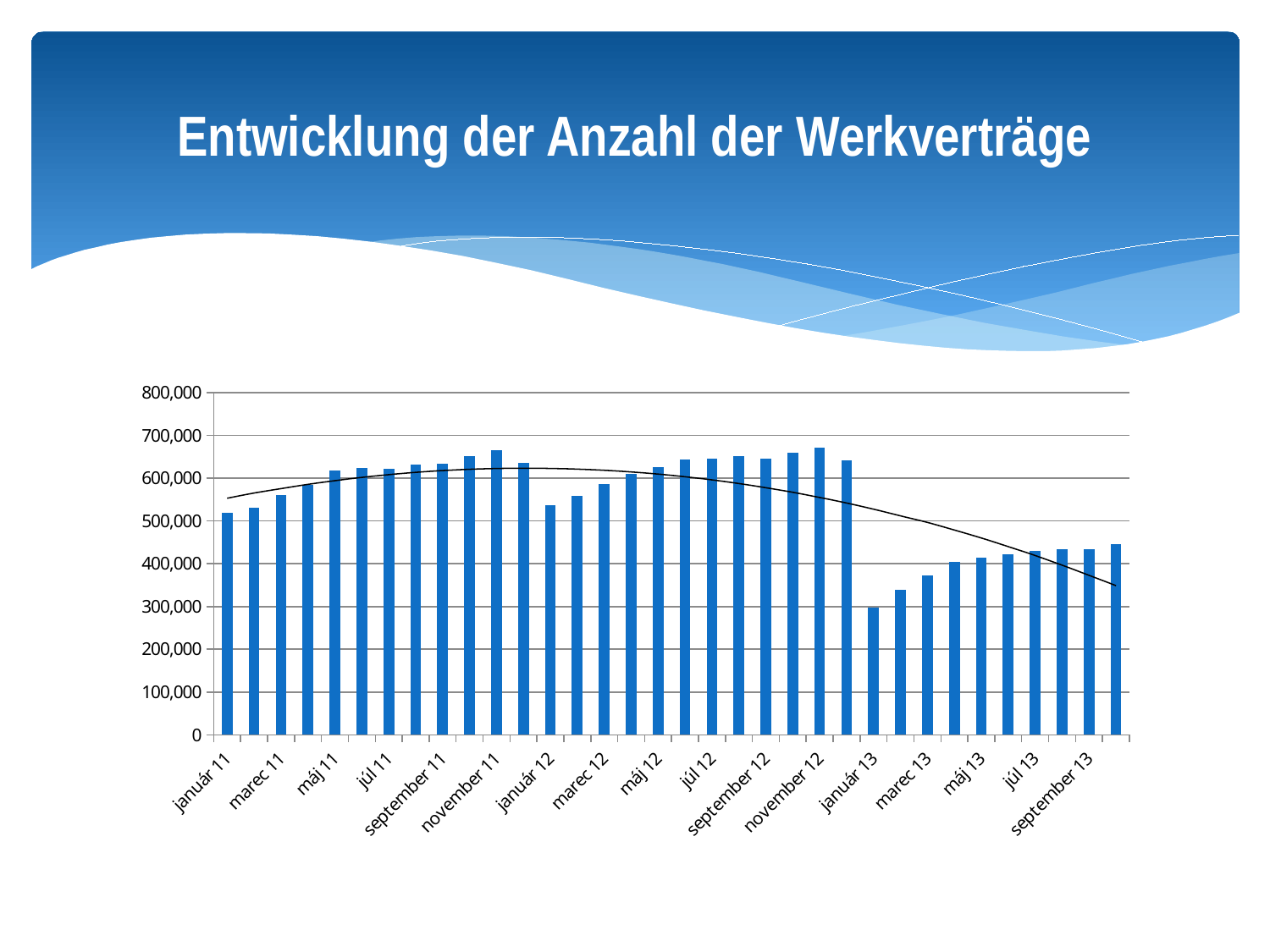
Which labelled month has the lowest value? január 13 Is the value for november 11 greater or less than 600,000? greater Which is larger, the value for november 12 or the value for január 13? november 12 Which is larger, the value for máj 11 or the value for máj 13? máj 11 Is the value for január 13 greater or less than 400,000? less What is the title of the slide? Entwicklung der Anzahl der Werkverträge Is the value for január 11 greater or less than 500,000? greater Do the values rise or fall from január 13 to september 13? rise What kind of chart is shown on the slide? bar chart Do the values rise or fall from január 11 to november 11? rise